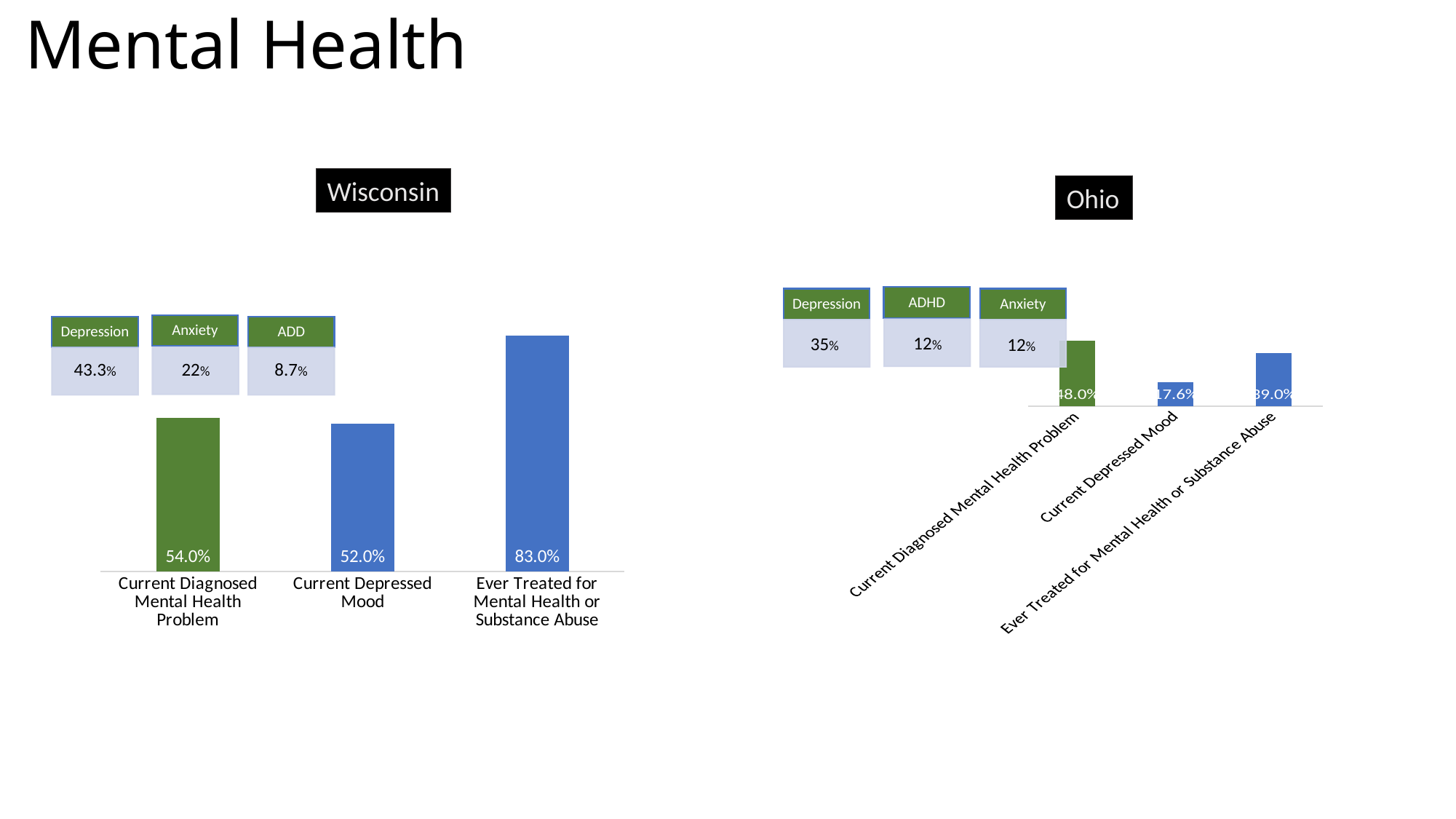
In the Wisconsin chart, what is the value for Current Diagnosed Mental Health Problem? 54.0% In the Wisconsin chart, what is the value for Ever Treated for Mental Health or Substance Abuse? 83.0% In the Wisconsin chart, what is the value for Current Depressed Mood? 52.0% In the Wisconsin chart, which category has the highest value? Ever Treated for Mental Health or Substance Abuse What kind of chart is the Wisconsin chart? Bar chart In the Wisconsin chart, how many categories are shown? 3 In the Wisconsin chart, which category has the lowest value? Current Depressed Mood In the Ohio chart, which category has the lowest value? Current Depressed Mood In the Wisconsin chart, what is the difference between Ever Treated for Mental Health or Substance Abuse and Current Diagnosed Mental Health Problem? 29.0% In the Wisconsin chart, what percentage is shown in the Depression box above the bars? 43.3% In the Ohio chart, which category has the highest value? Current Diagnosed Mental Health Problem In the Ohio chart, which is larger: Current Diagnosed Mental Health Problem or Ever Treated for Mental Health or Substance Abuse? Current Diagnosed Mental Health Problem